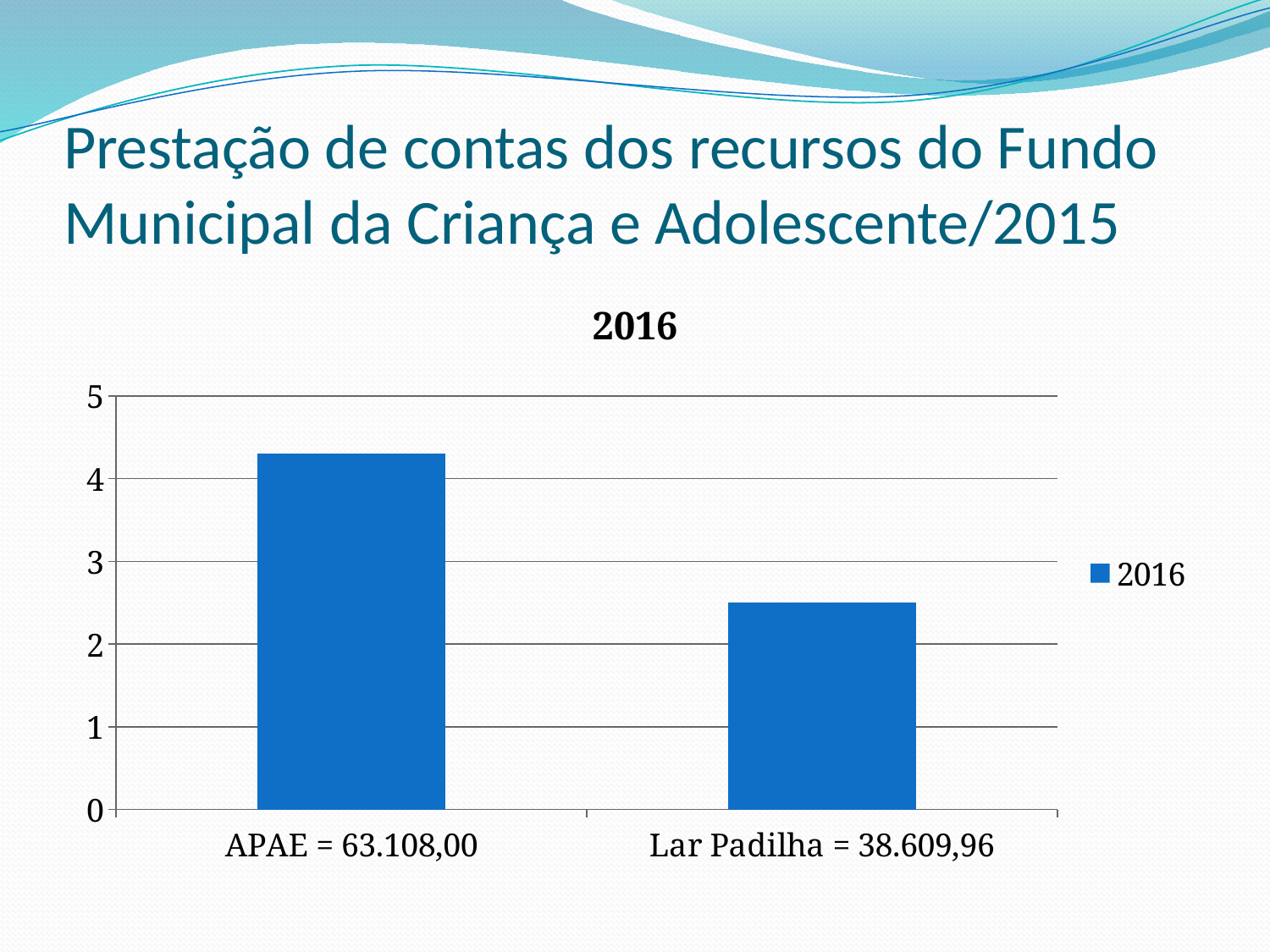
Which category has the tallest bar? APAE = 63.108,00 What amount is written in the category label for Lar Padilha? 38.609,96 Is the value for Lar Padilha greater or less than 3? less How many bars does the chart have? 2 Is the value for APAE greater or less than 4? greater Is the bar for APAE taller or shorter than the bar for Lar Padilha? taller Which category has the shortest bar? Lar Padilha = 38.609,96 What is the title of the chart? 2016 What type of chart is shown on the slide? bar chart What amount is written in the category label for APAE? 63.108,00 Is the value for Lar Padilha greater or less than 2? greater How many series does the legend list? 1